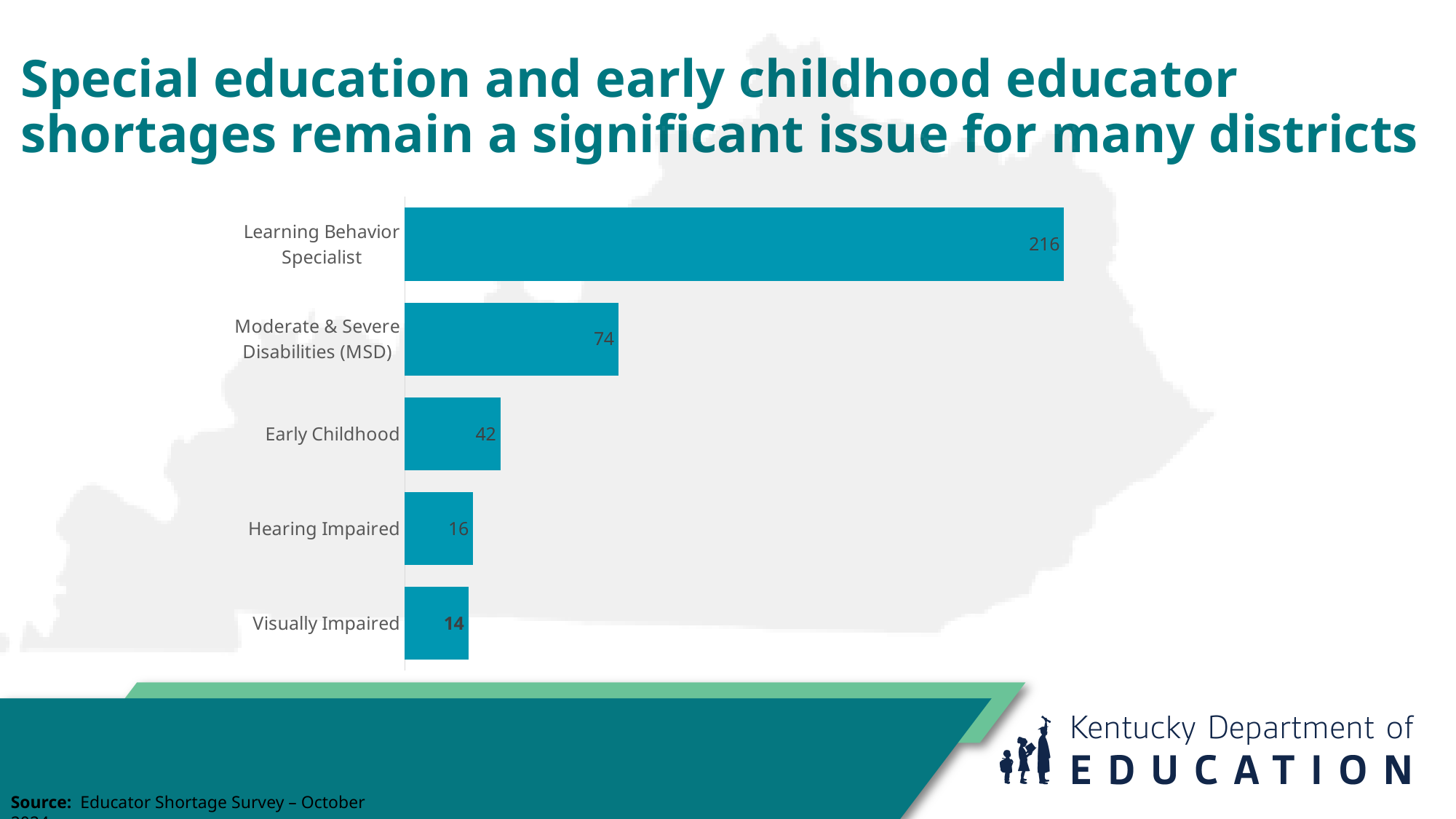
Which category has the lowest value? Visually Impaired Which is larger, the value for Moderate & Severe Disabilities (MSD) or the value for Early Childhood? Moderate & Severe Disabilities (MSD) What is the value for Learning Behavior Specialist? 216 What is the difference between the values for Early Childhood and Hearing Impaired? 26 What is the value for Moderate & Severe Disabilities (MSD)? 74 How many categories are shown in the chart? 5 What kind of chart is shown on the slide? Bar chart What is the value for Hearing Impaired? 16 What is the value for Visually Impaired? 14 What is the value for Early Childhood? 42 Which category has the highest value? Learning Behavior Specialist What is the difference between the values for Learning Behavior Specialist and Moderate & Severe Disabilities (MSD)? 142